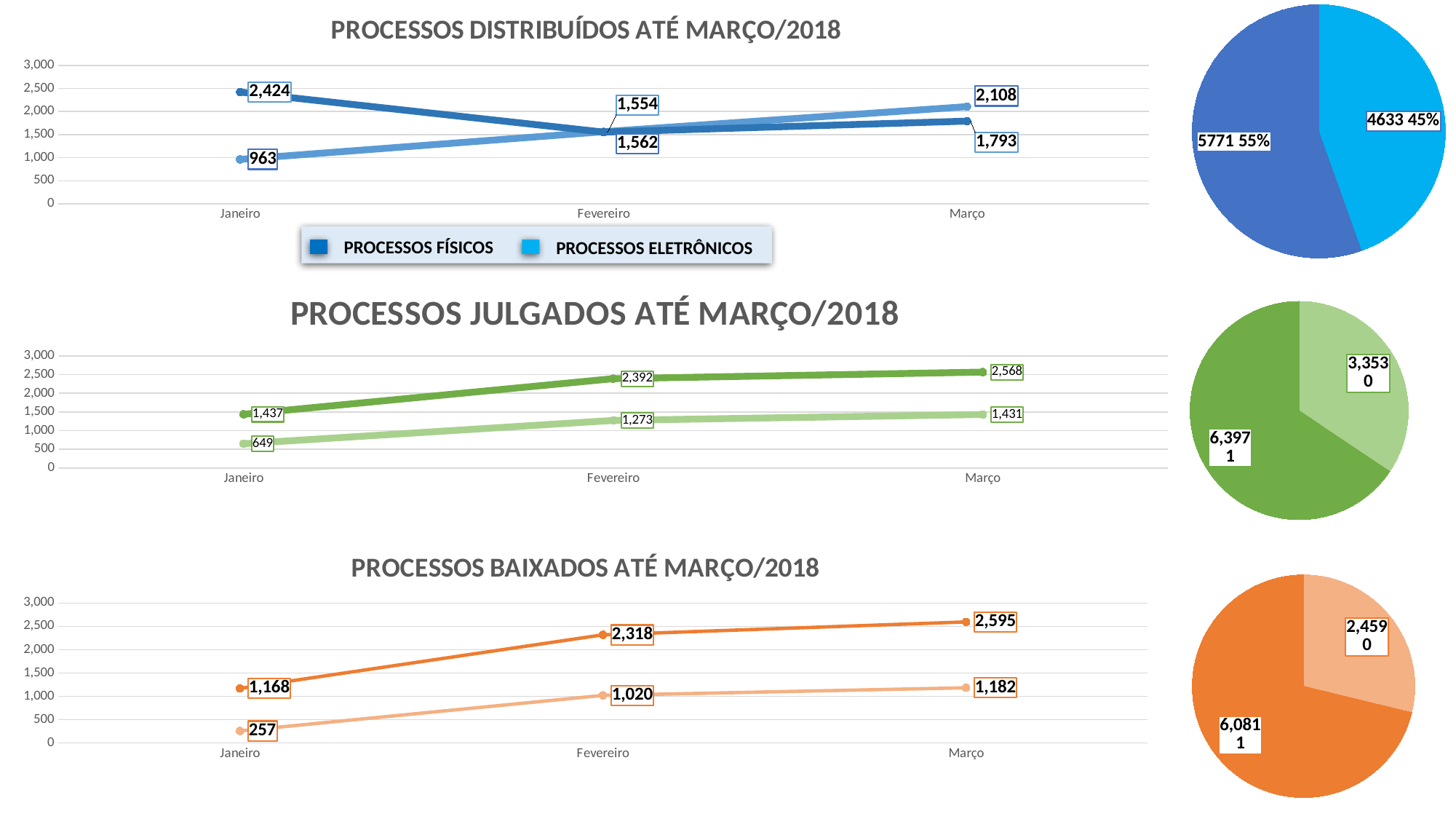
In the chart titled PROCESSOS DISTRIBUÍDOS ATÉ MARÇO/2018, how many series does the legend list? 2 In the chart titled PROCESSOS DISTRIBUÍDOS ATÉ MARÇO/2018, what is the difference between PROCESSOS FÍSICOS and PROCESSOS ELETRÔNICOS in Janeiro? 1,461 In the chart titled PROCESSOS DISTRIBUÍDOS ATÉ MARÇO/2018, does the PROCESSOS ELETRÔNICOS line rise or fall from Janeiro to Março? rise In the chart titled PROCESSOS BAIXADOS ATÉ MARÇO/2018, which is larger in Março: the darker orange line or the lighter orange line? the darker orange line In the chart titled PROCESSOS BAIXADOS ATÉ MARÇO/2018, how many months are shown on the x axis? 3 In the chart titled PROCESSOS JULGADOS ATÉ MARÇO/2018, what is the value of the darker green line in Março? 2,568 In the chart titled PROCESSOS DISTRIBUÍDOS ATÉ MARÇO/2018, what is the value for PROCESSOS FÍSICOS in Janeiro? 2,424 In the pie chart at the top right of the slide, what share does the slice labelled 5771 have? 55% In the chart titled PROCESSOS DISTRIBUÍDOS ATÉ MARÇO/2018, what is the value for PROCESSOS ELETRÔNICOS in Março? 2,108 In the chart titled PROCESSOS BAIXADOS ATÉ MARÇO/2018, what is the value of the lighter orange line in Fevereiro? 1,020 What kind of chart is the one titled PROCESSOS JULGADOS ATÉ MARÇO/2018? line chart In the chart titled PROCESSOS JULGADOS ATÉ MARÇO/2018, in which month is the lighter green line lowest? Janeiro